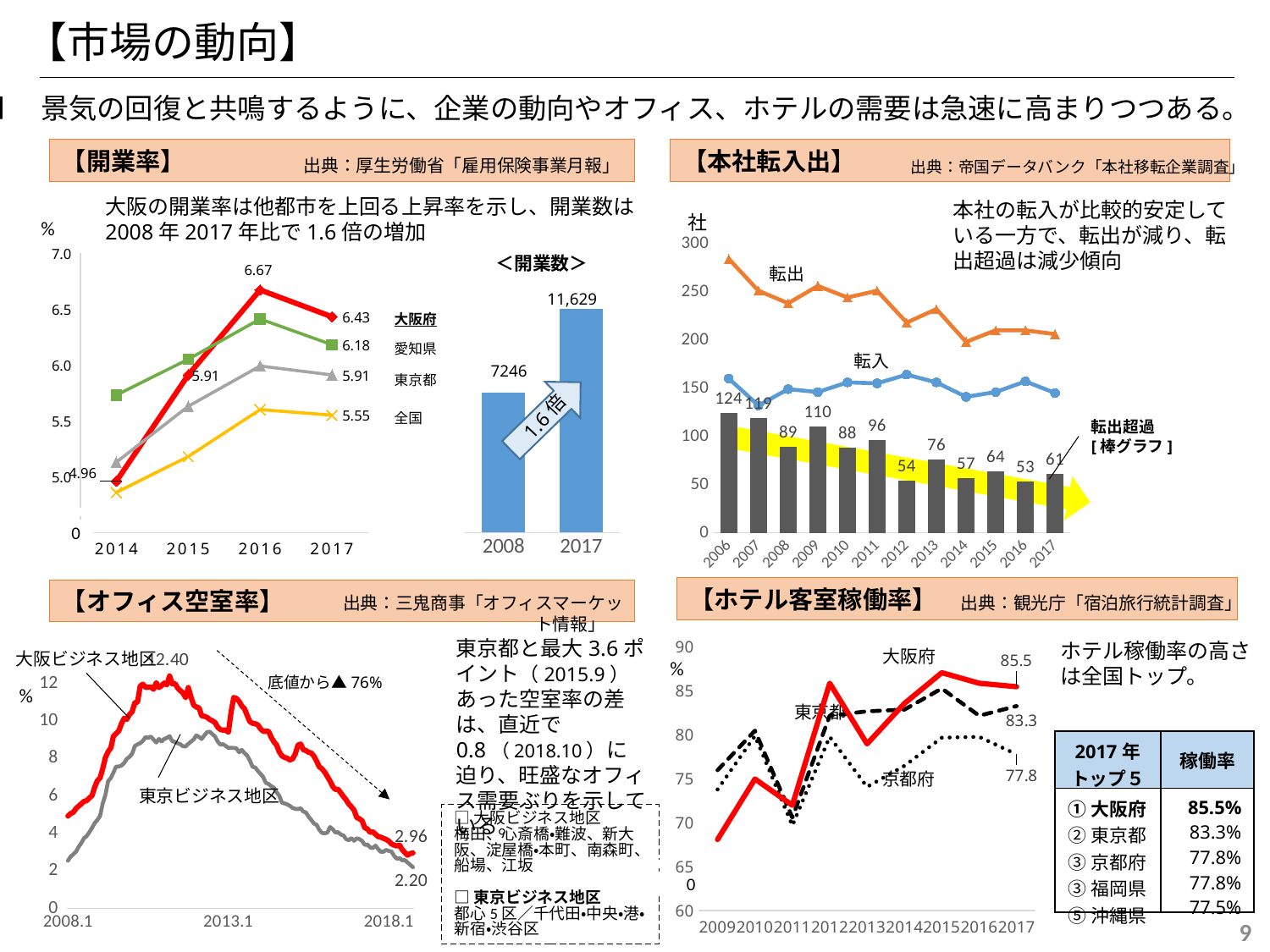
What kind of chart is the ＜開業数＞ chart? bar chart In the 【開業率】 chart, what is the value for 大阪府 in 2016? 6.67 In the 【開業率】 chart, what is the value for 大阪府 in 2017? 6.43 In the 【本社転入出】 chart, which year has the highest 転出超過 value? 2006 In the ＜開業数＞ bar chart, what is the value for 2017? 11,629 In the 【開業率】 chart, which series has the highest value in 2017? 大阪府 In the 【本社転入出】 chart, does the 転出 line generally rise or fall from 2006 to 2017? fall In the 【ホテル客室稼働率】 chart, what is the value for 大阪府 in 2017? 85.5 In the ＜開業数＞ chart, what is the difference between the 2017 and 2008 values? 4,383 In the 【本社転入出】 chart, how many years are shown on the x axis? 12 In the 【本社転入出】 chart, what is the 転出超過 value for 2006? 124 In the 【ホテル客室稼働率】 chart, what is the difference between the 2017 values for 大阪府 and 東京都? 2.2